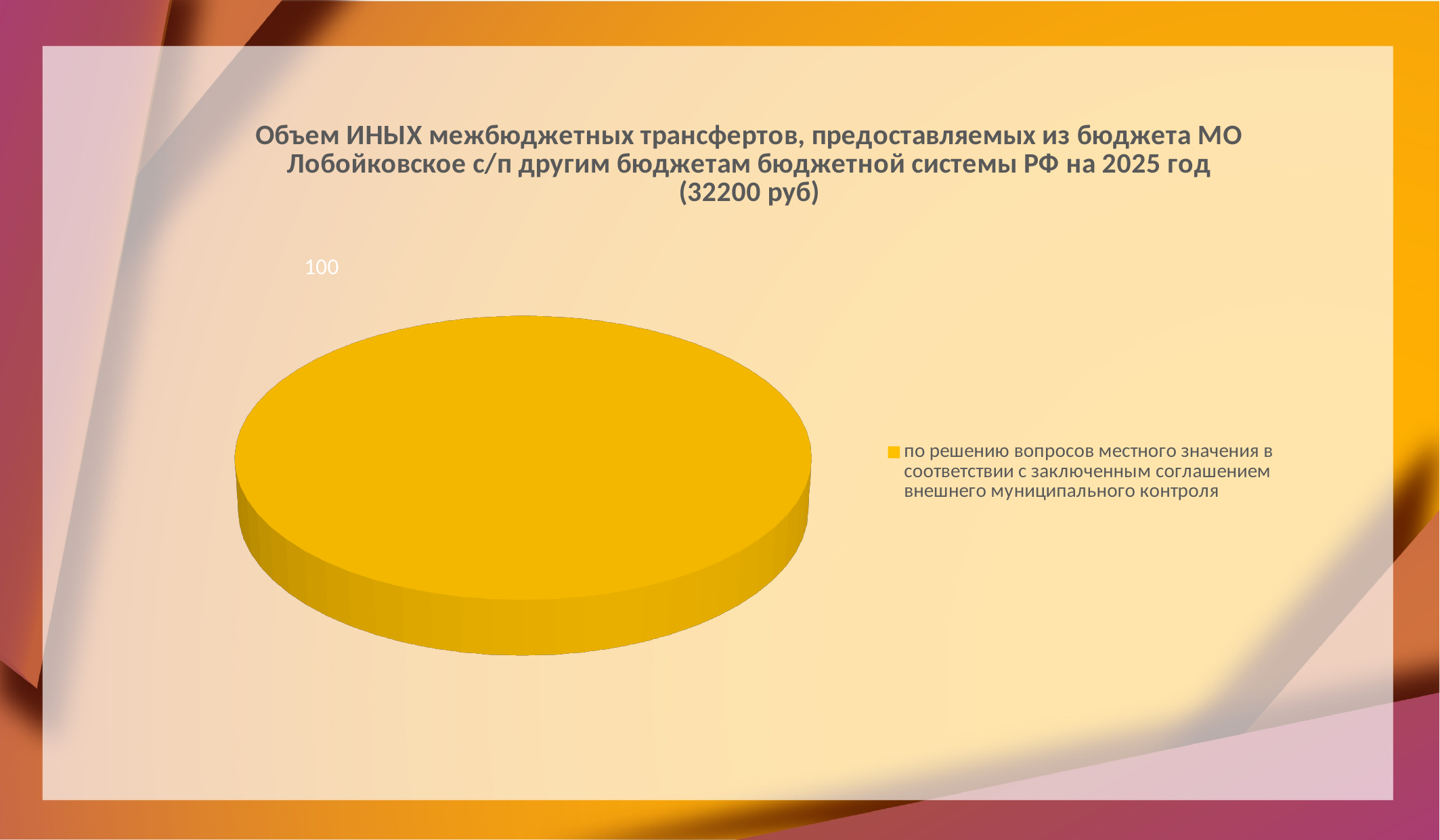
What value is printed as the data label on the pie chart? 100 How many entries does the legend of the pie chart list? 1 What share of the pie does the single slice occupy? 100% What total amount in rubles is stated in the chart title? 32200 руб What kind of chart is shown on the slide? pie chart What is the value for the category 'по решению вопросов местного значения в соответствии с заключенным соглашением внешнего муниципального контроля'? 100 What colour is the slice of the pie chart? yellow How many slices does the pie chart have? 1